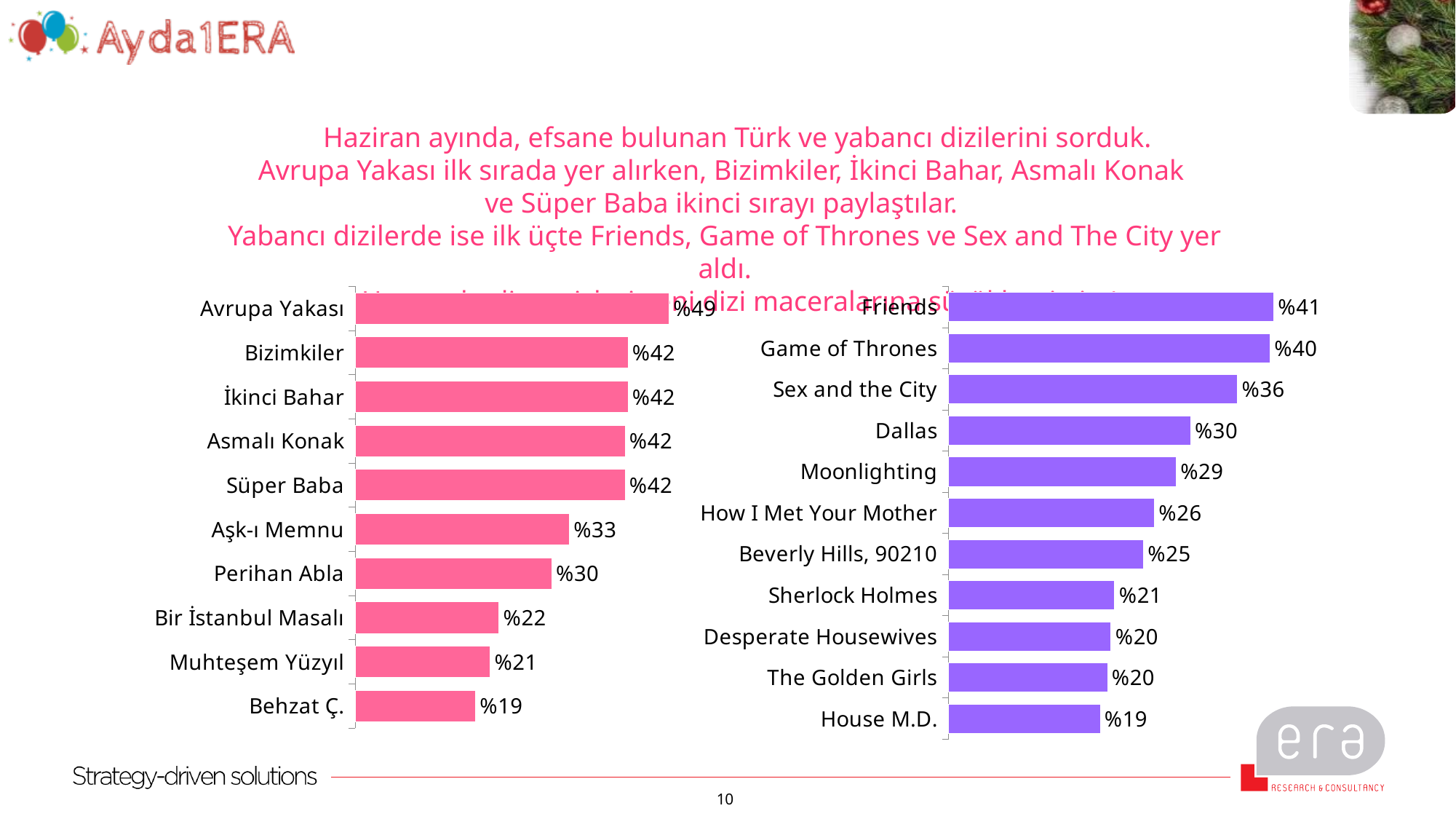
What type of chart is the right chart? Bar chart In the left chart, which series has the lowest value? Behzat Ç. In the left chart, what is the value for Avrupa Yakası? %49 In the right chart, what is the value for Sex and the City? %36 How many series are listed in the left chart? 10 In the right chart, which series has the lowest value? House M.D. In the right chart, which has a larger value, Moonlighting or Sherlock Holmes? Moonlighting In the right chart, what is the difference between the values for Friends and Dallas? %11 In the left chart, what is the value for Perihan Abla? %30 In the left chart, what is the difference between the values for Avrupa Yakası and Bizimkiler? %7 How many series are listed in the right chart? 11 In the right chart, which series has the highest value? Friends